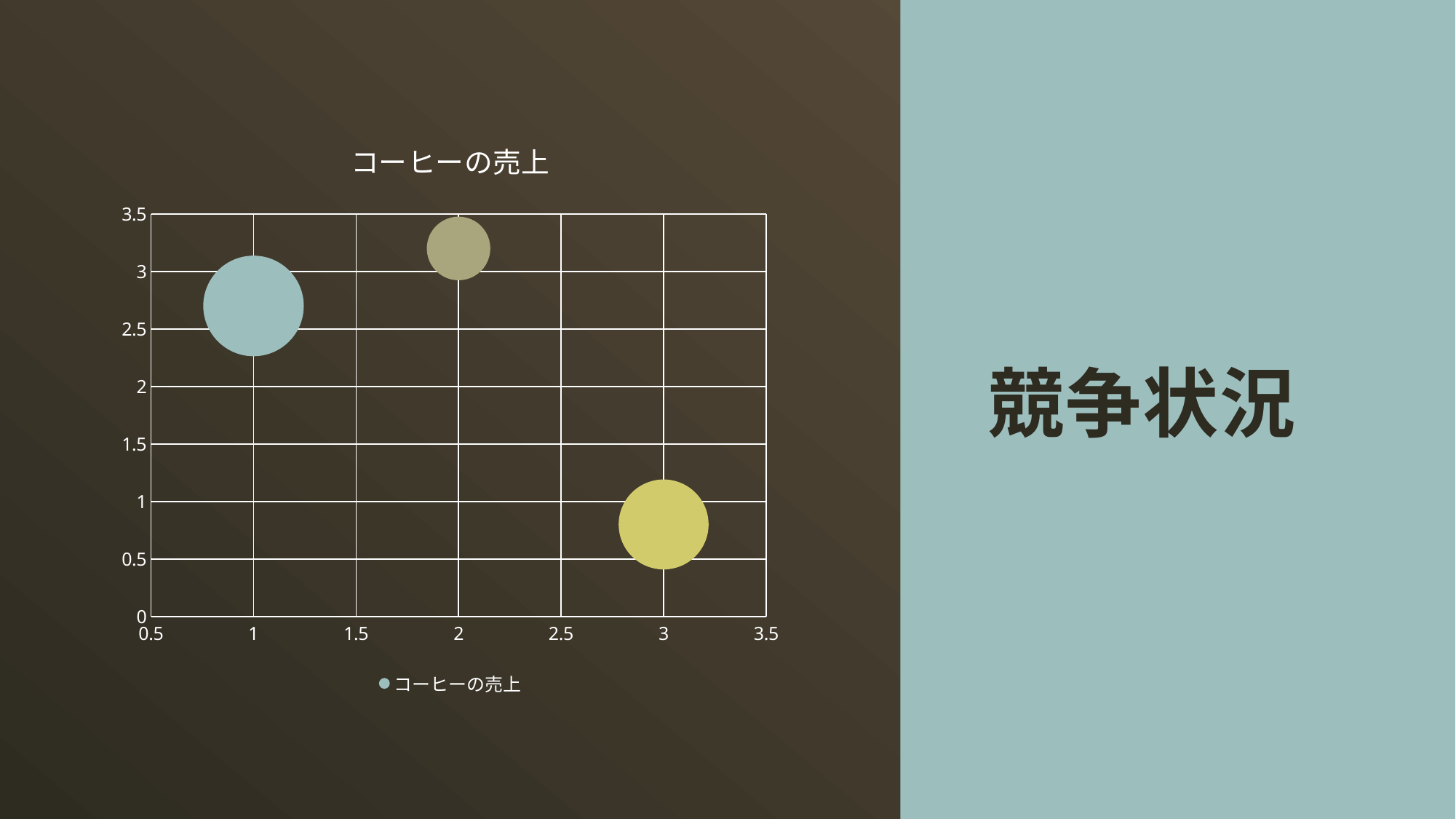
What is the title of the chart? コーヒーの売上 Which bubble is the smallest in size: the one at x = 1, x = 2, or x = 3? x = 2 Is the y value of the bubble at x = 2 greater or less than 3? greater Is the y value of the bubble at x = 3 greater or less than 1? less Is the y value of the bubble at x = 1 greater or less than 2? greater What series name appears in the legend? コーヒーの売上 How many series does the legend list? 1 Which bubble has the highest y value: the one at x = 1, x = 2, or x = 3? x = 2 Which bubble has the larger y value, the one at x = 1 or the one at x = 3? x = 1 How many bubbles are plotted on the chart? 3 Which bubble has the lowest y value: the one at x = 1, x = 2, or x = 3? x = 3 What kind of chart is shown on the slide? Bubble chart